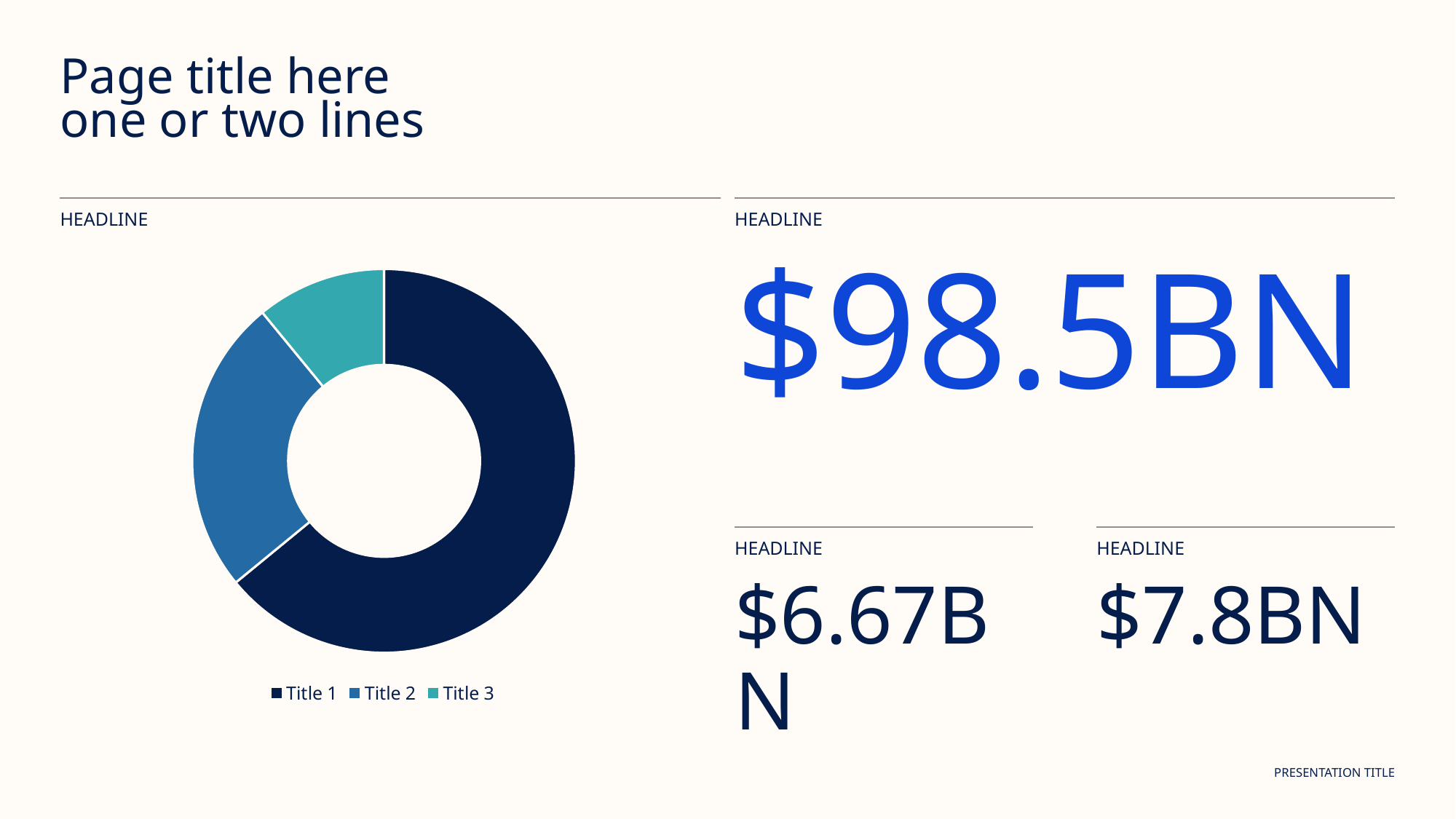
Which category has the largest slice in the doughnut chart? Title 1 How many entries does the legend of the doughnut chart list? 3 What are the legend entries of the doughnut chart, in order? Title 1, Title 2, Title 3 In the doughnut chart, which slice is larger: Title 1 or Title 2? Title 1 What kind of chart is shown on the left of the slide? Doughnut chart In the doughnut chart, which slice is larger: Title 2 or Title 3? Title 2 What colour is the Title 3 slice in the doughnut chart? Teal Which category has the smallest slice in the doughnut chart? Title 3 How many slices does the doughnut chart have? 3 Does the Title 1 slice take up more or less than half of the doughnut chart? more